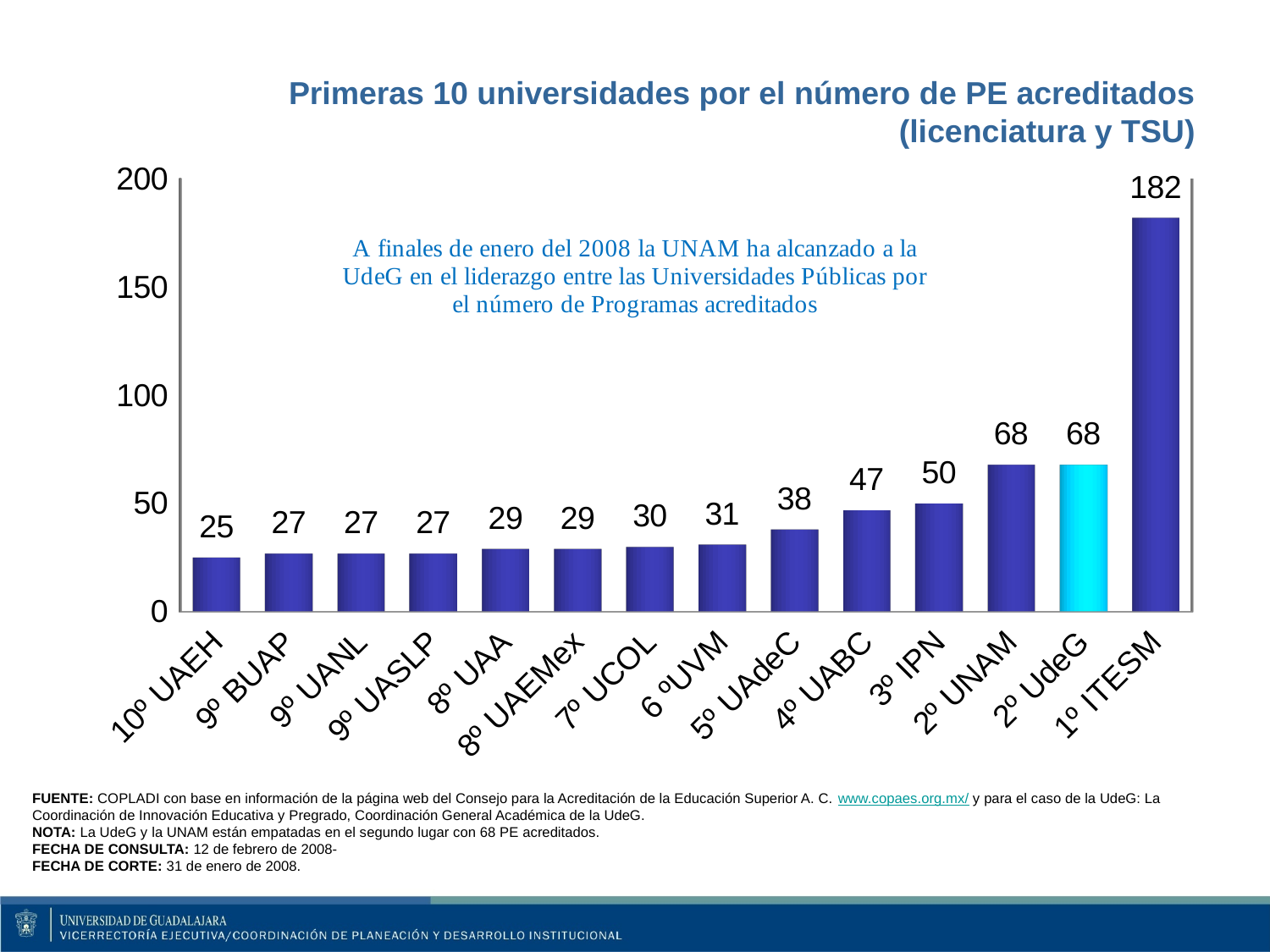
What is the difference between the values for 1º ITESM and 2º UNAM? 114 What is the value for 1º ITESM? 182 Which bar is drawn in a different colour (light blue) from the others? 2º UdeG What is the value for 10º UAEH? 25 What is the value for 5º UAdeC? 38 Which category has the highest value? 1º ITESM How many bars are plotted in the chart? 14 Which category has the lowest value? 10º UAEH What is the difference between the values for 4º UABC and 5º UAdeC? 9 What kind of chart is shown on the slide? Bar chart What is the value for 3º IPN? 50 Which is larger, the value for 3º IPN or the value for 4º UABC? 3º IPN